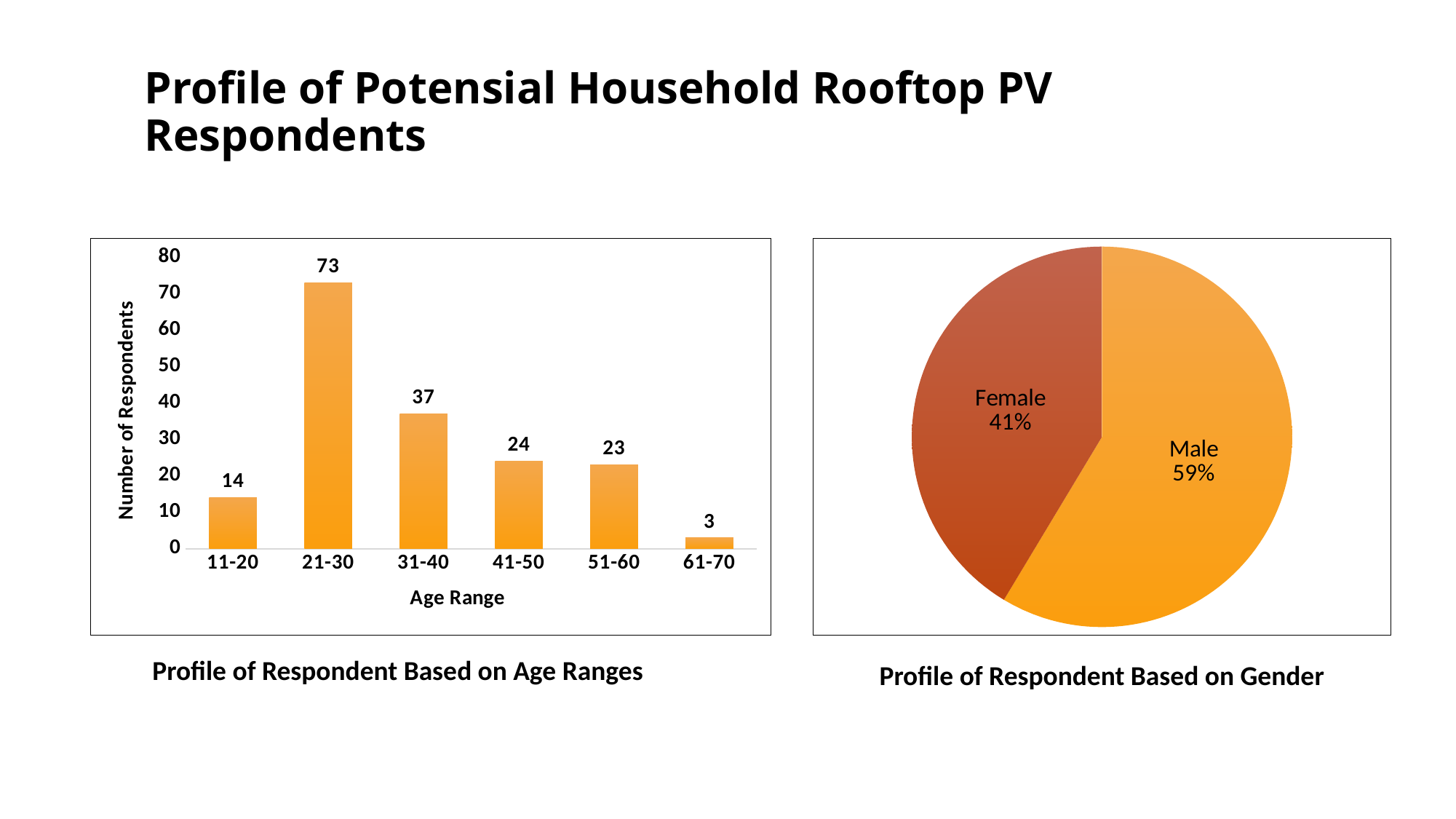
In the 'Profile of Respondent Based on Age Ranges' chart, how many respondents are in the 61-70 age range? 3 In the 'Profile of Respondent Based on Age Ranges' chart, which age range has the lowest number of respondents? 61-70 In the 'Profile of Respondent Based on Gender' chart, what share of respondents are Male? 59% In the 'Profile of Respondent Based on Age Ranges' chart, what is the label of the y axis? Number of Respondents In the 'Profile of Respondent Based on Age Ranges' chart, what is the difference in respondents between the 21-30 and 31-40 age ranges? 36 In the 'Profile of Respondent Based on Age Ranges' chart, which age range has the highest number of respondents? 21-30 What kind of chart is 'Profile of Respondent Based on Age Ranges'? Bar chart What kind of chart is 'Profile of Respondent Based on Gender'? Pie chart In the 'Profile of Respondent Based on Age Ranges' chart, how many age range categories are shown? 6 In the 'Profile of Respondent Based on Age Ranges' chart, which age range has more respondents, 11-20 or 51-60? 51-60 In the 'Profile of Respondent Based on Gender' chart, what share of respondents are Female? 41% In the 'Profile of Respondent Based on Age Ranges' chart, how many respondents are in the 21-30 age range? 73